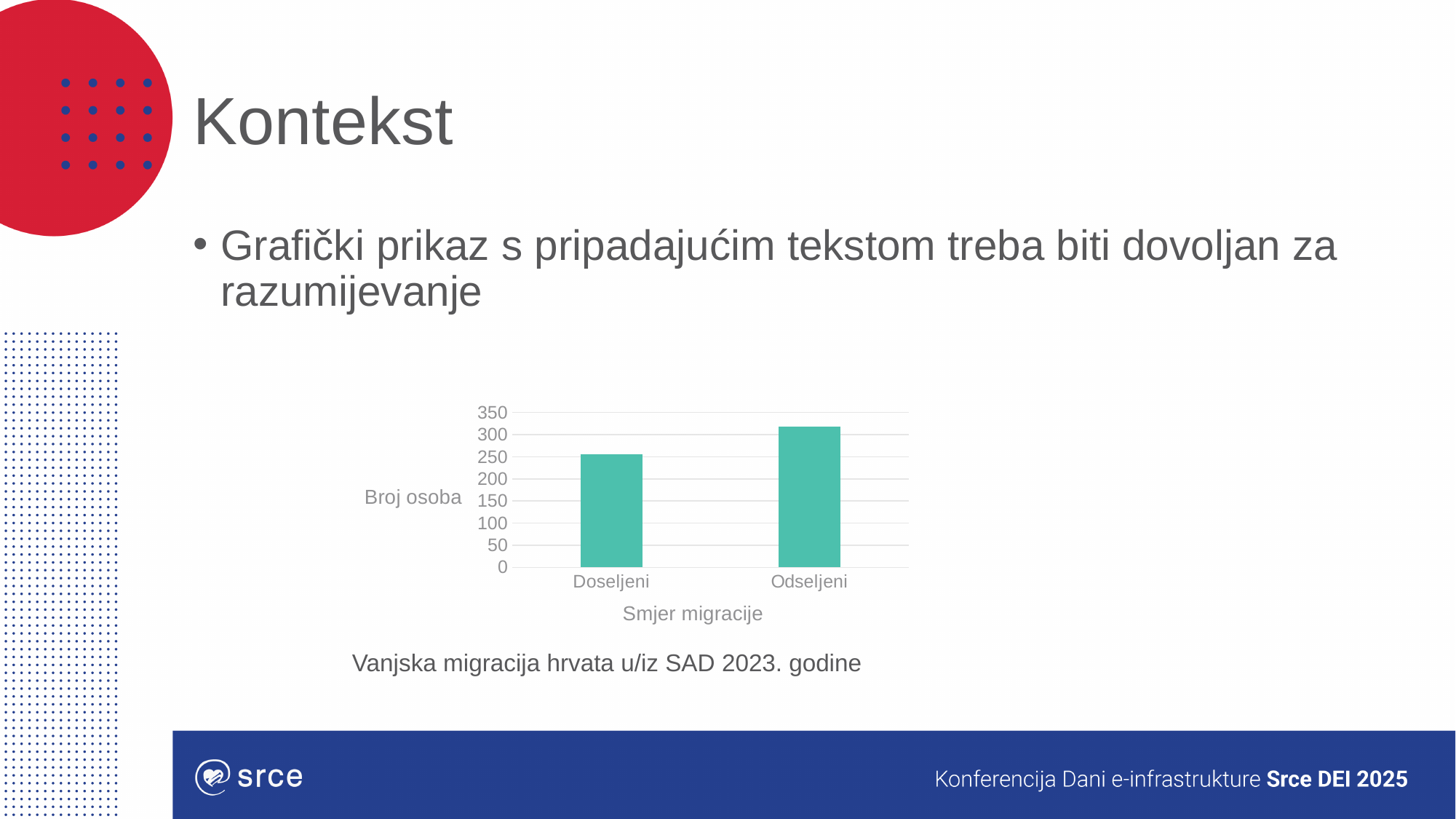
What is the label of the horizontal axis of the chart? Smjer migracije Which category has the lowest bar in the chart? Doseljeni How many categories are shown on the x axis of the chart? 2 Which is larger, the value for Doseljeni or the value for Odseljeni? Odseljeni Which category has the highest bar in the chart? Odseljeni What kind of chart is shown on the slide? bar chart Is the value for Doseljeni greater or less than 300? less Is the value for Odseljeni greater or less than 350? less What is the label of the vertical axis of the chart? Broj osoba Is the value for Odseljeni greater or less than 300? greater